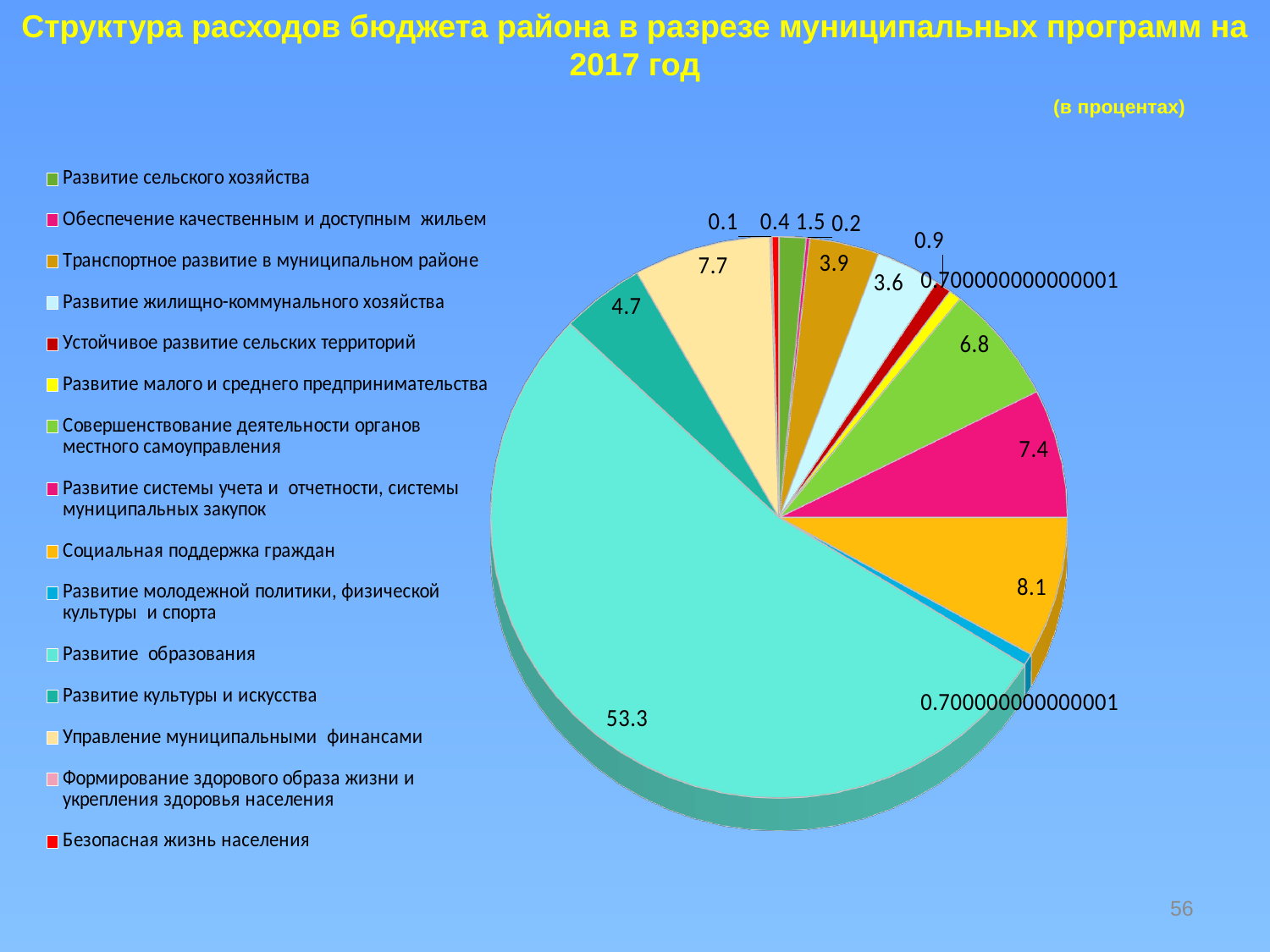
How many categories does the legend list? 15 Which category has the largest share of the pie? Развитие образования What is the value for Развитие образования? 53.3 In what units are the values shown, according to the note under the title? в процентах What is the value for Управление муниципальными финансами? 7.7 Which is larger, the value for Социальная поддержка граждан or the value for Развитие системы учета и отчетности, системы муниципальных закупок? Социальная поддержка граждан What is the value for Совершенствование деятельности органов местного самоуправления? 6.8 What is the value for Социальная поддержка граждан? 8.1 What kind of chart is shown on the slide? pie chart Which category has the smallest share of the pie? Формирование здорового образа жизни и укрепления здоровья населения What is the value for Развитие культуры и искусства? 4.7 What is the difference between the value for Развитие образования and the value for Социальная поддержка граждан? 45.2